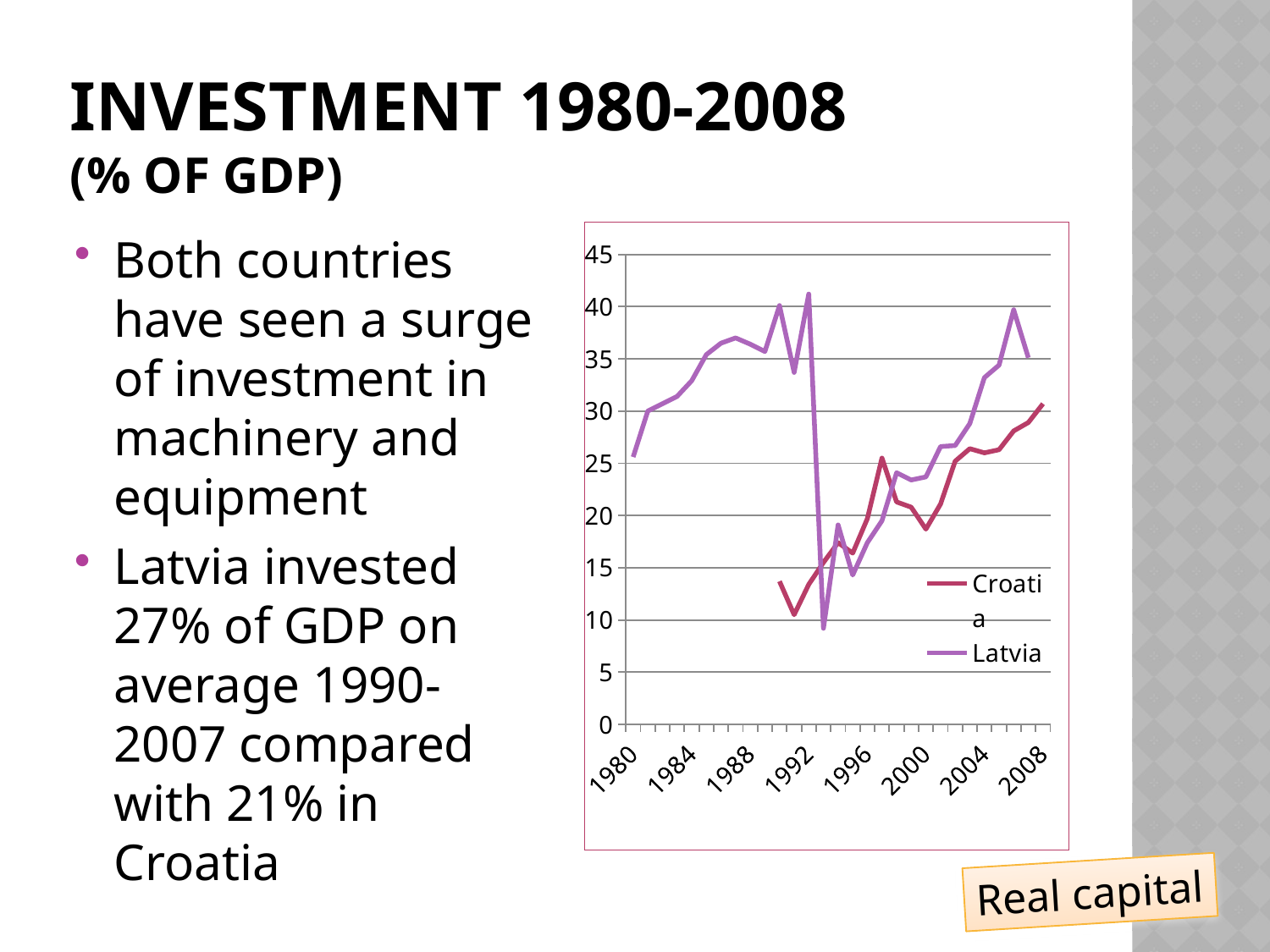
What kind of chart is shown on the slide? line chart Which series reaches the highest value anywhere on the chart? Latvia How many series does the chart legend list? 2 What colour is the Latvia line in the chart? purple Does the Croatia line rise or fall between 2000 and 2008? rise Is the value for Latvia in 1980 greater or less than 20? greater Which two countries are plotted in the chart? Croatia and Latvia Is the value for Croatia in 1991 greater or less than 15? less Is the value for Latvia in 1993 greater or less than 15? less In 1997, which series has the higher value, Croatia or Latvia? Croatia